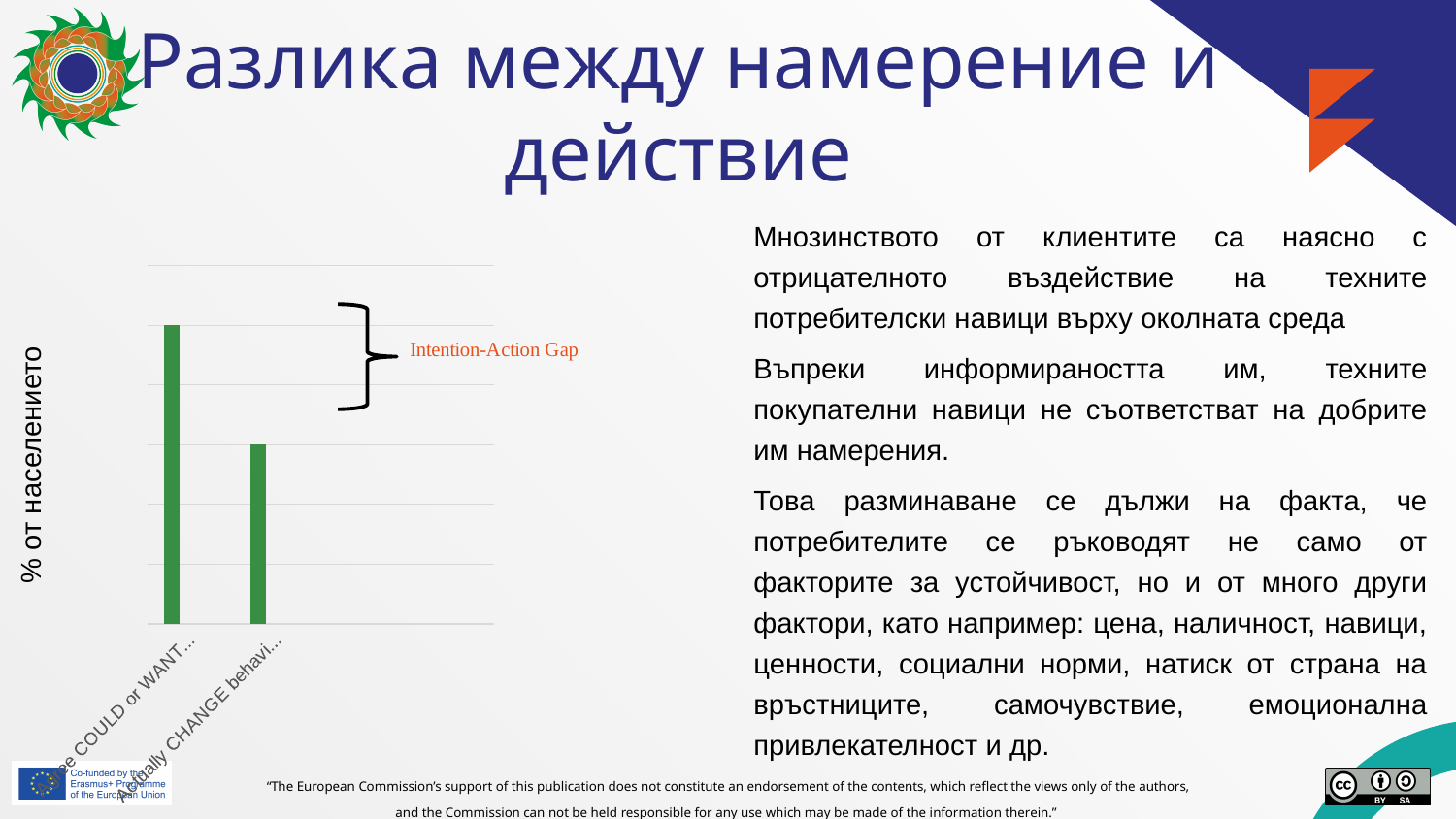
What text does the bracket annotation next to the chart read? Intention-Action Gap Which bar in the chart is the lowest? the right bar Do the bar values rise or fall from left to right along the x axis? fall What is the label on the vertical axis of the chart? % от населението What kind of chart is shown on the slide? bar chart Which bar is taller, the left bar or the right bar? the left bar Which bar in the chart is the highest? the left bar How many bars does the chart show? 2